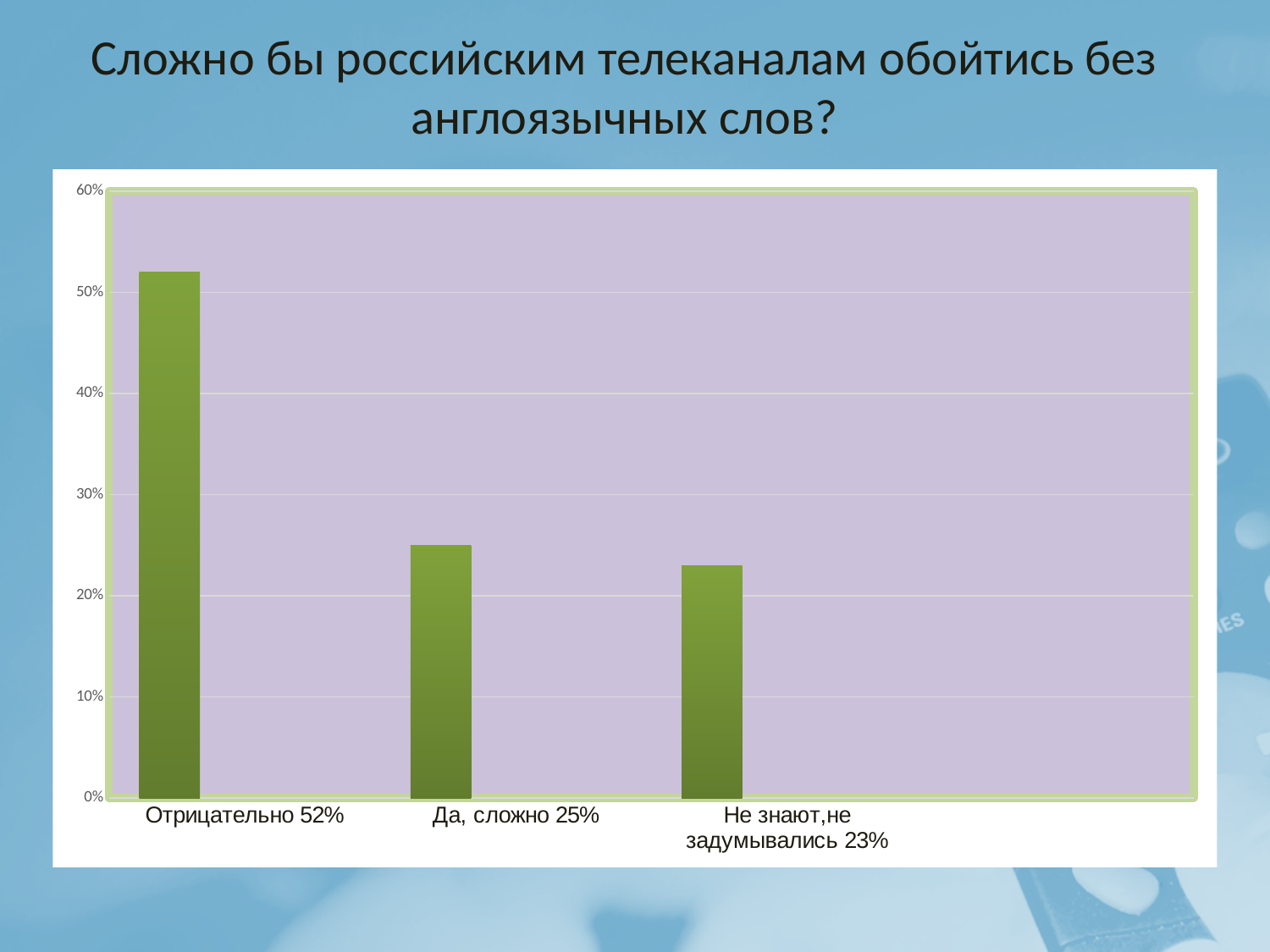
What is the difference between the values for "Да, сложно" and "Не знают, не задумывались"? 2% What is the value for the category "Да, сложно"? 25% Which category has the lowest value? Не знают, не задумывались Which category has the highest value? Отрицательно Is the value for "Отрицательно" greater or less than 50%? greater What kind of chart is shown on the slide? Bar chart Which is larger: the value for "Отрицательно" or the value for "Не знают, не задумывались"? Отрицательно How many categories are shown in the chart? 3 What is the difference between the values for "Отрицательно" and "Да, сложно"? 27% What is the value for the category "Не знают, не задумывались"? 23% Is the value for "Да, сложно" greater or less than 30%? less What is the value for the category "Отрицательно"? 52%